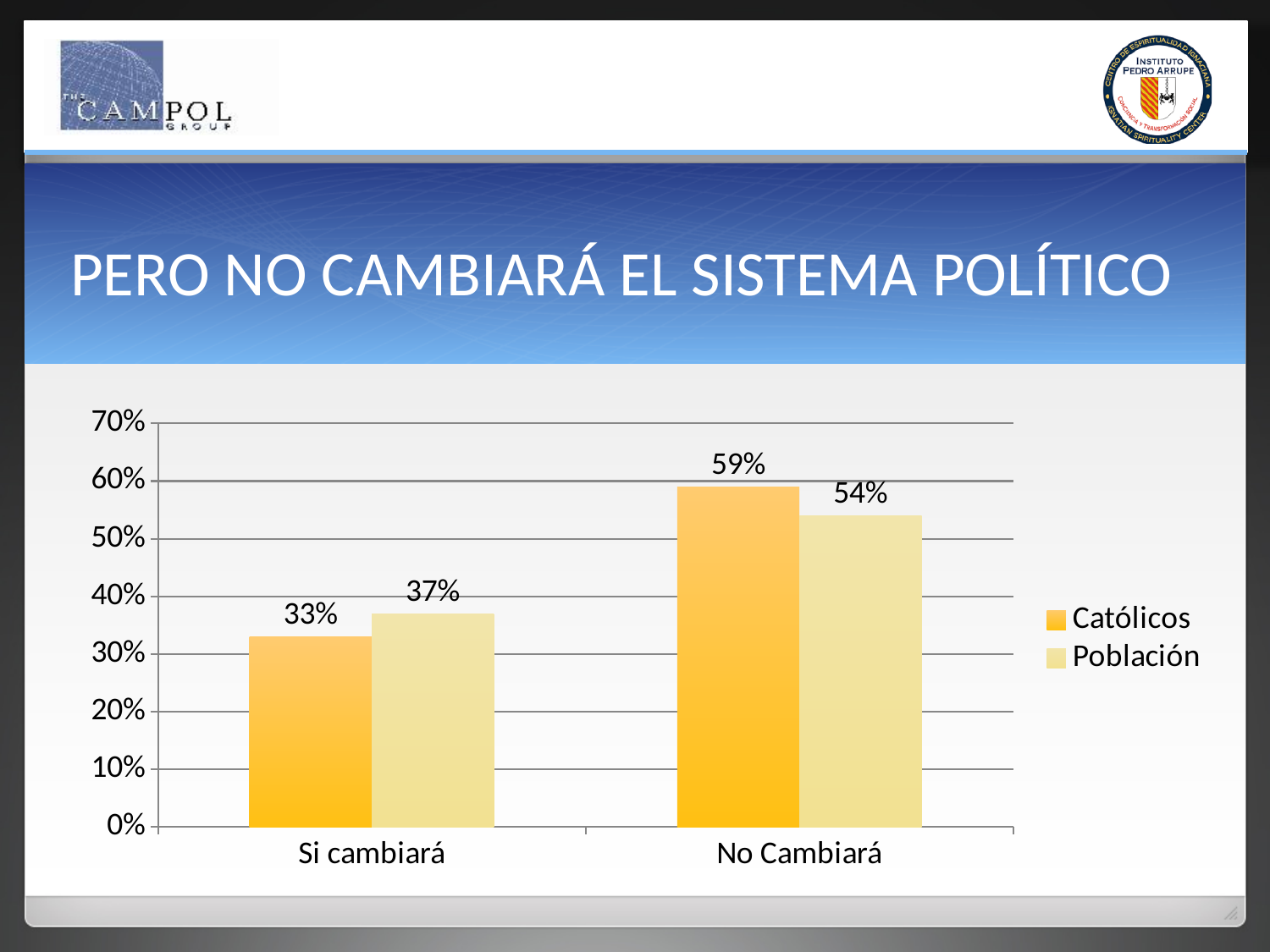
How many categories are shown on the x axis? 2 Is the value for Católicos in 'No Cambiará' greater or less than 50%? greater What is the value for Católicos in the 'No Cambiará' category? 59% How many series does the legend list? 2 What is the difference between the Católicos and Población values in the 'No Cambiará' category? 5% Which category has the highest value for Católicos? No Cambiará What is the value for Población in the 'Si cambiará' category? 37% What is the value for Católicos in the 'Si cambiará' category? 33% In the 'Si cambiará' category, which series has the larger value, Católicos or Población? Población What kind of chart is shown on the slide? bar chart What is the value for Población in the 'No Cambiará' category? 54% Which category has the lowest value for Población? Si cambiará